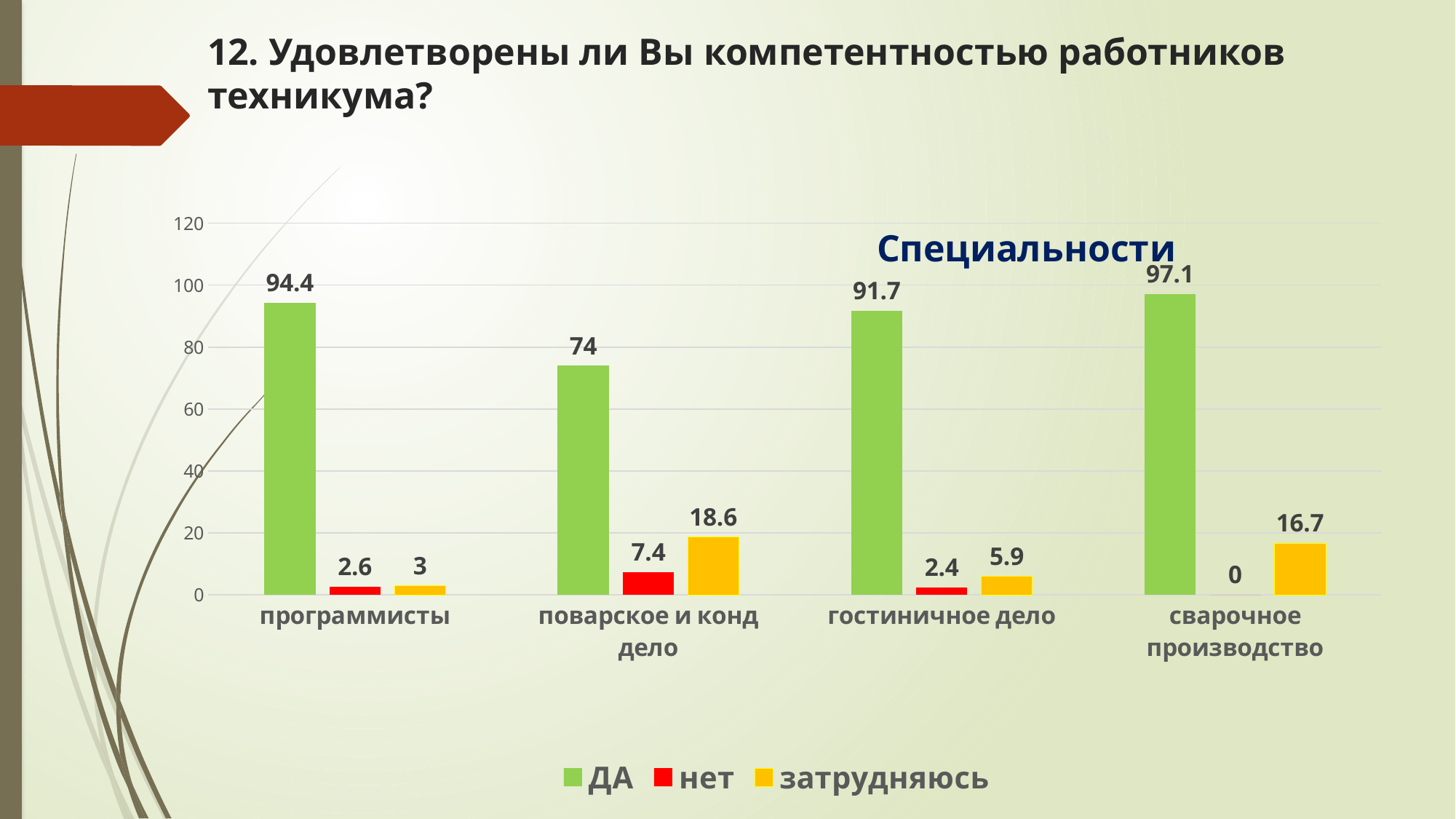
Which category has the lowest ДА value? поварское и конд дело What is the value of затрудняюсь for поварское и конд дело? 18.6 What is the value of ДА for программисты? 94.4 Which is larger: the затрудняюсь value for поварское и конд дело or for сварочное производство? поварское и конд дело What is the difference between the ДА values for сварочное производство and поварское и конд дело? 23.1 Which colour represents the нет series? red How many series does the legend list? 3 Which category has the highest ДА value? сварочное производство How many categories are shown on the x axis? 4 What is the value of нет for сварочное производство? 0 What kind of chart is shown on the slide? bar chart What is the value of нет for гостиничное дело? 2.4